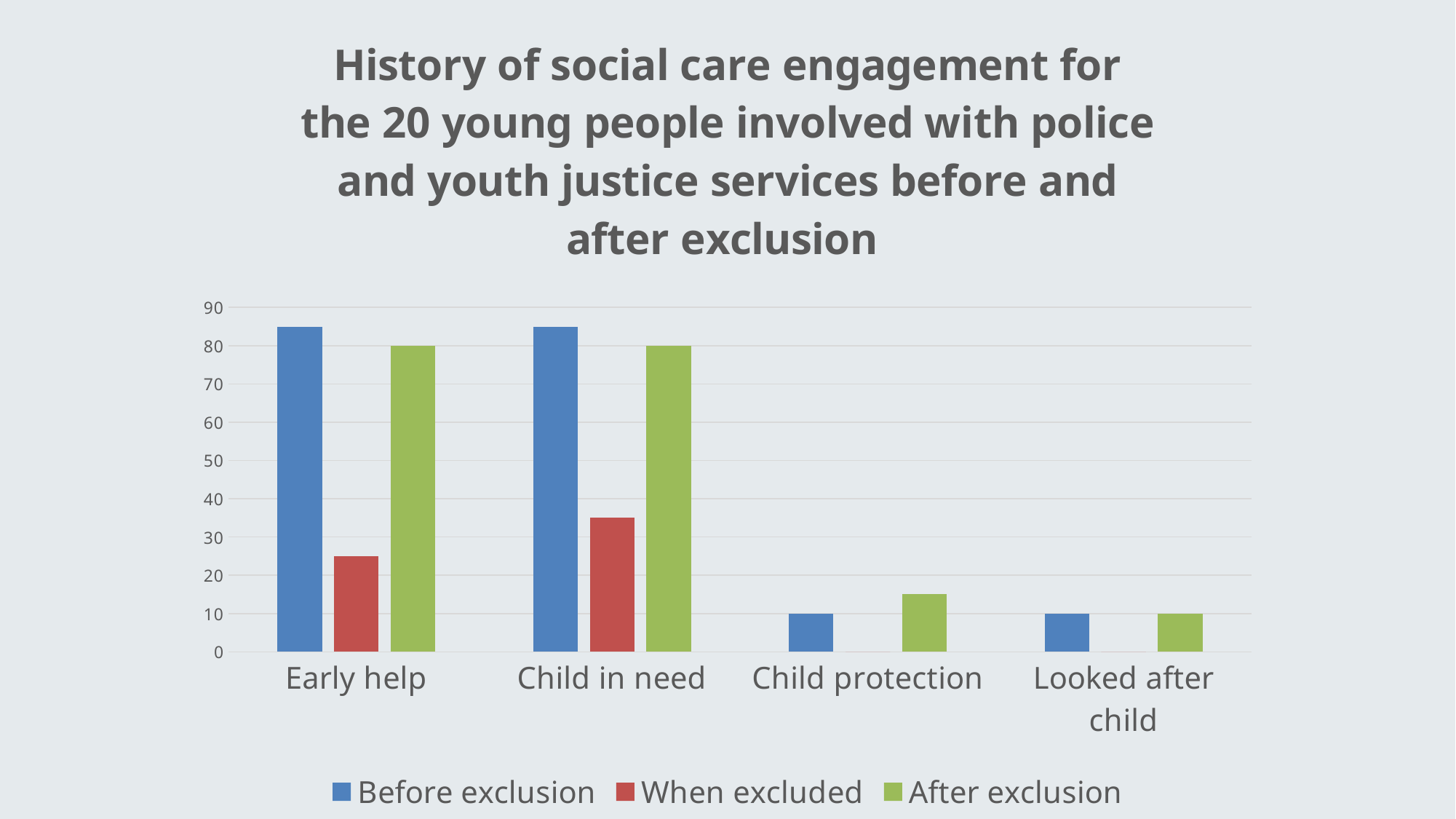
Is the value for Before exclusion in the Early help category greater or less than 80? greater Which is larger in the Child in need category, the When excluded value or the After exclusion value? After exclusion Which category has the lowest value for After exclusion? Looked after child What is the value for Before exclusion in the Looked after child category? 10 Is the value for When excluded in the Early help category greater or less than 30? less Is the value for When excluded in the Child in need category greater or less than 30? greater How many series does the legend list? 3 What is the value for After exclusion in the Early help category? 80 What is the value for Before exclusion in the Child protection category? 10 What kind of chart is shown on the slide? bar chart How many categories are shown on the x axis? 4 What is the value for After exclusion in the Child in need category? 80